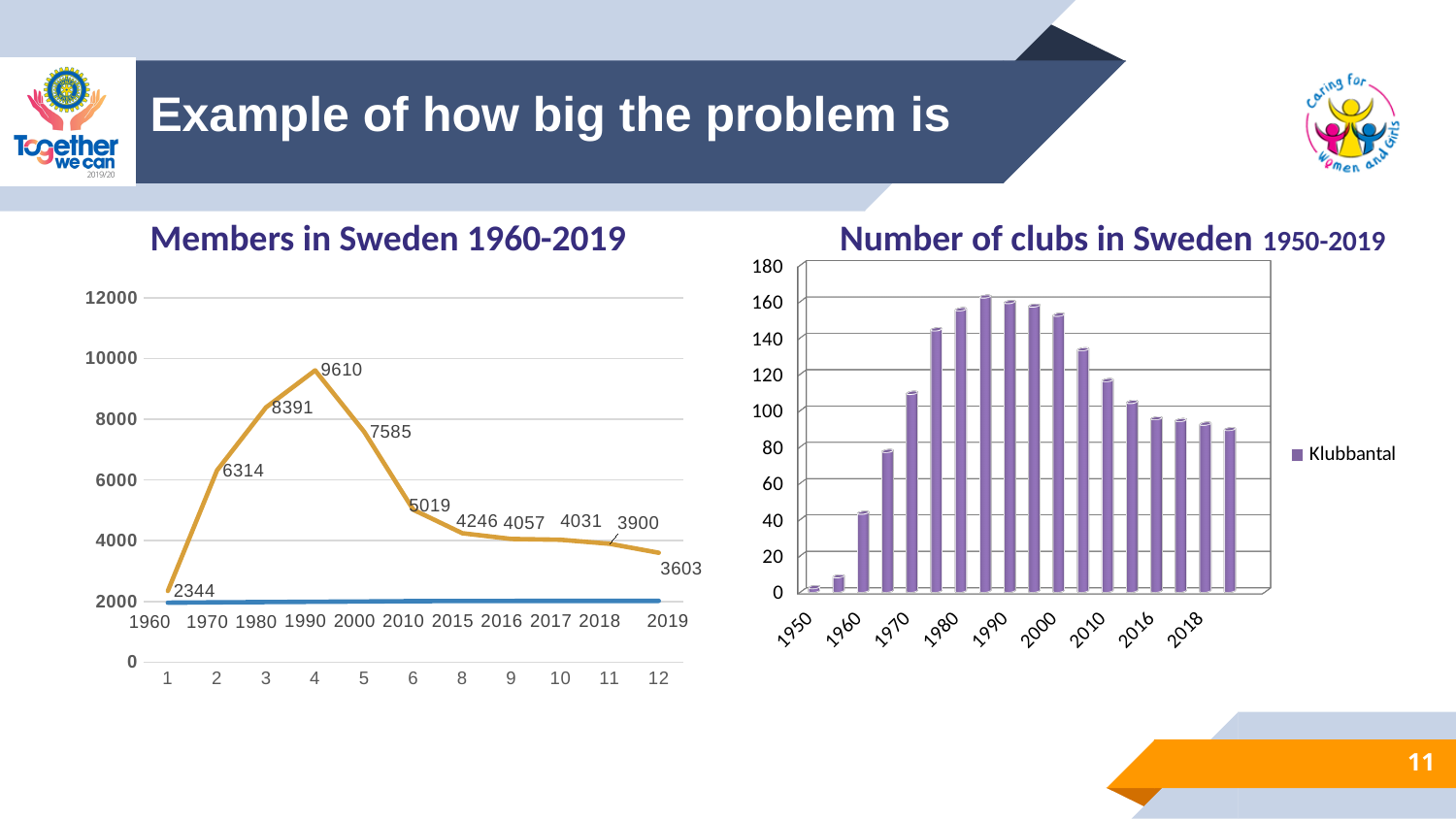
In the 'Members in Sweden 1960-2019' chart, what is the value for 1990? 9610 In the 'Number of clubs in Sweden 1950-2019' chart, is the value for 2018 greater or less than 100? less What series name does the legend of the 'Number of clubs in Sweden 1950-2019' chart show? Klubbantal In the 'Members in Sweden 1960-2019' chart, what is the value for 2019? 3603 In the 'Members in Sweden 1960-2019' chart, what is the difference between the values for 1990 and 2019? 6007 What kind of chart is 'Number of clubs in Sweden 1950-2019'? bar chart In the 'Members in Sweden 1960-2019' chart, which is larger, the value for 2000 or the value for 2010? 2000 In the 'Members in Sweden 1960-2019' chart, which year has the highest number of members? 1990 In the 'Members in Sweden 1960-2019' chart, which year has the lowest number of members? 1960 In the 'Members in Sweden 1960-2019' chart, do the values rise or fall from 2010 to 2019? fall In the 'Members in Sweden 1960-2019' chart, what is the value for 1960? 2344 In the 'Number of clubs in Sweden 1950-2019' chart, is the value for 1980 greater or less than 140? greater